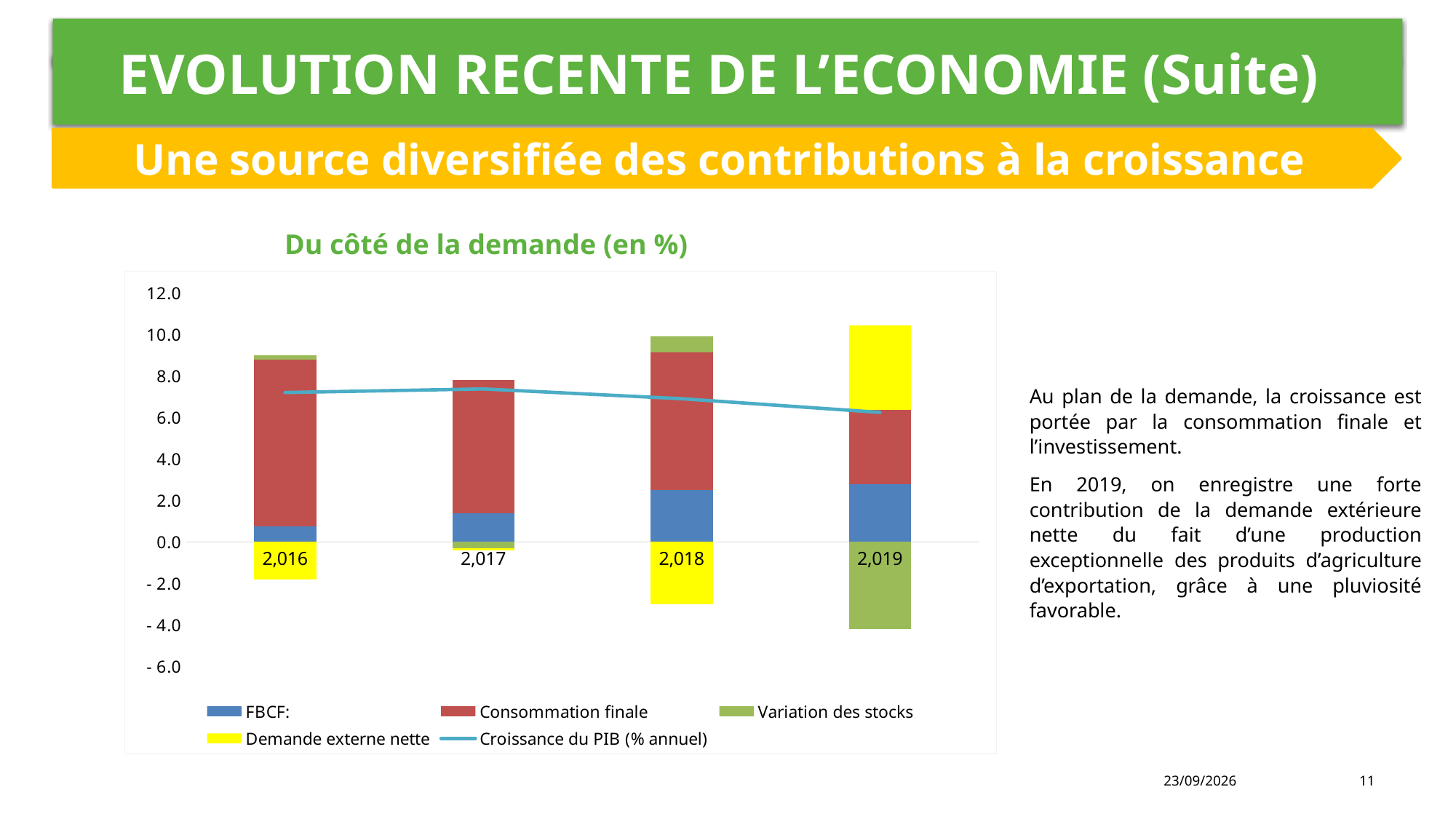
Is the FBCF contribution for 2,016 greater or less than 2.0? less Is the FBCF contribution for 2,019 greater or less than 2.0? greater What is the title of the chart? Du côté de la demande (en %) Which colour represents 'Demande externe nette' in the chart? Yellow Does the 'Croissance du PIB (% annuel)' line rise or fall from 2,017 to 2,019? fall Is the value of 'Croissance du PIB (% annuel)' for 2,017 greater or less than 8.0? less How many series does the chart legend list? 5 How many years are shown on the x axis of the chart? 4 Which year has the larger FBCF contribution, 2,016 or 2,019? 2,019 In which year is the 'Croissance du PIB (% annuel)' line at its lowest? 2,019 What kind of chart is shown under the title 'Du côté de la demande (en %)'? Stacked bar chart with a line